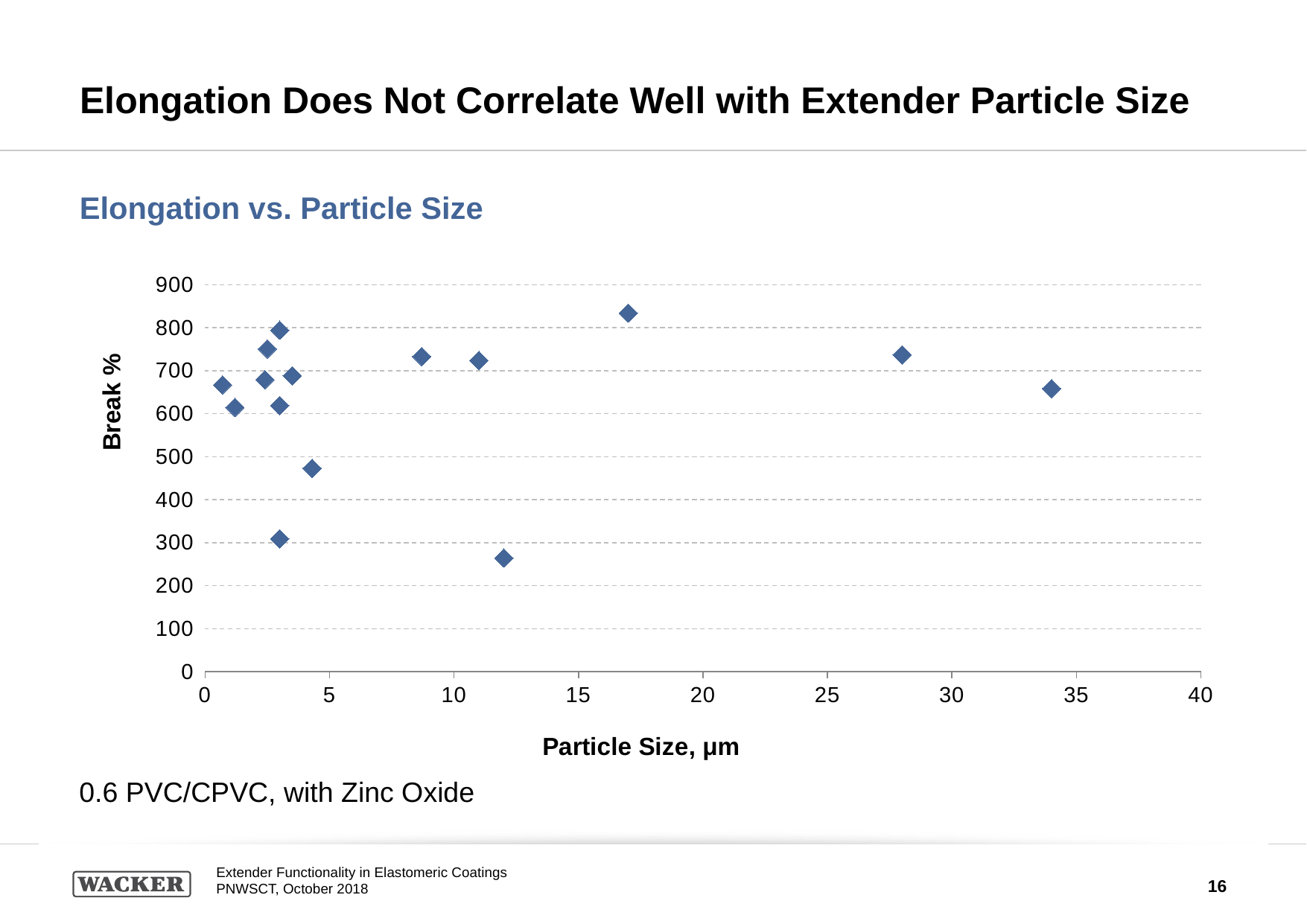
What is the title of the chart? Elongation vs. Particle Size Is the Break % value for the point at a particle size of about 17 µm greater or less than 800? greater Is the Break % value for the point at a particle size of about 34 µm greater or less than 700? less What kind of chart is shown on the slide? scatter chart What is the label of the x axis of the chart? Particle Size, µm Is the Break % value for the point at a particle size of about 28 µm greater or less than 700? greater Is the point with the highest Break % located at a particle size greater or less than 15 µm? greater Which point has the higher Break %: the one near 17 µm or the one near 28 µm? the one near 17 µm Do the Break % values show a consistent rise or fall as particle size increases along the x axis? no clear trend How many data points are plotted on the chart? 15